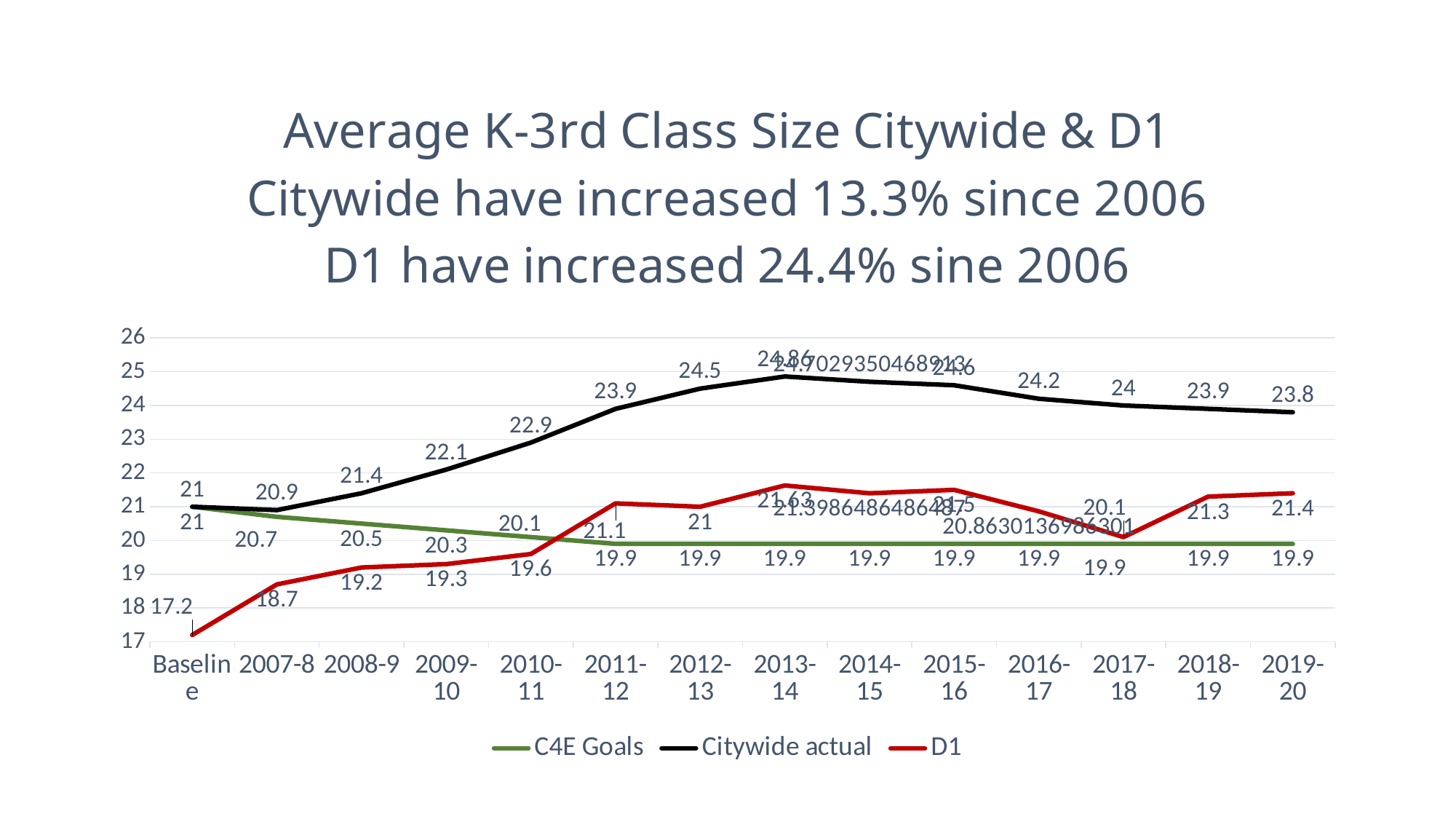
What is the C4E Goals value for 2009-10? 20.3 In which year is the D1 value lowest? Baseline By how much did the Citywide actual value change from Baseline (21) to 2019-20 (23.8)? 2.8 What is the Citywide actual value for 2012-13? 24.5 What type of chart is shown on the slide? line chart How many series does the legend list? 3 What is the D1 value at Baseline? 17.2 What colour is the D1 line in the legend? red In 2019-20, which is larger: the D1 value or the C4E Goals value? D1 How many school-year categories are plotted along the x axis, including Baseline? 14 Is the Citywide actual value for 2013-14 greater or less than 24? greater What is the Citywide actual value for 2019-20? 23.8